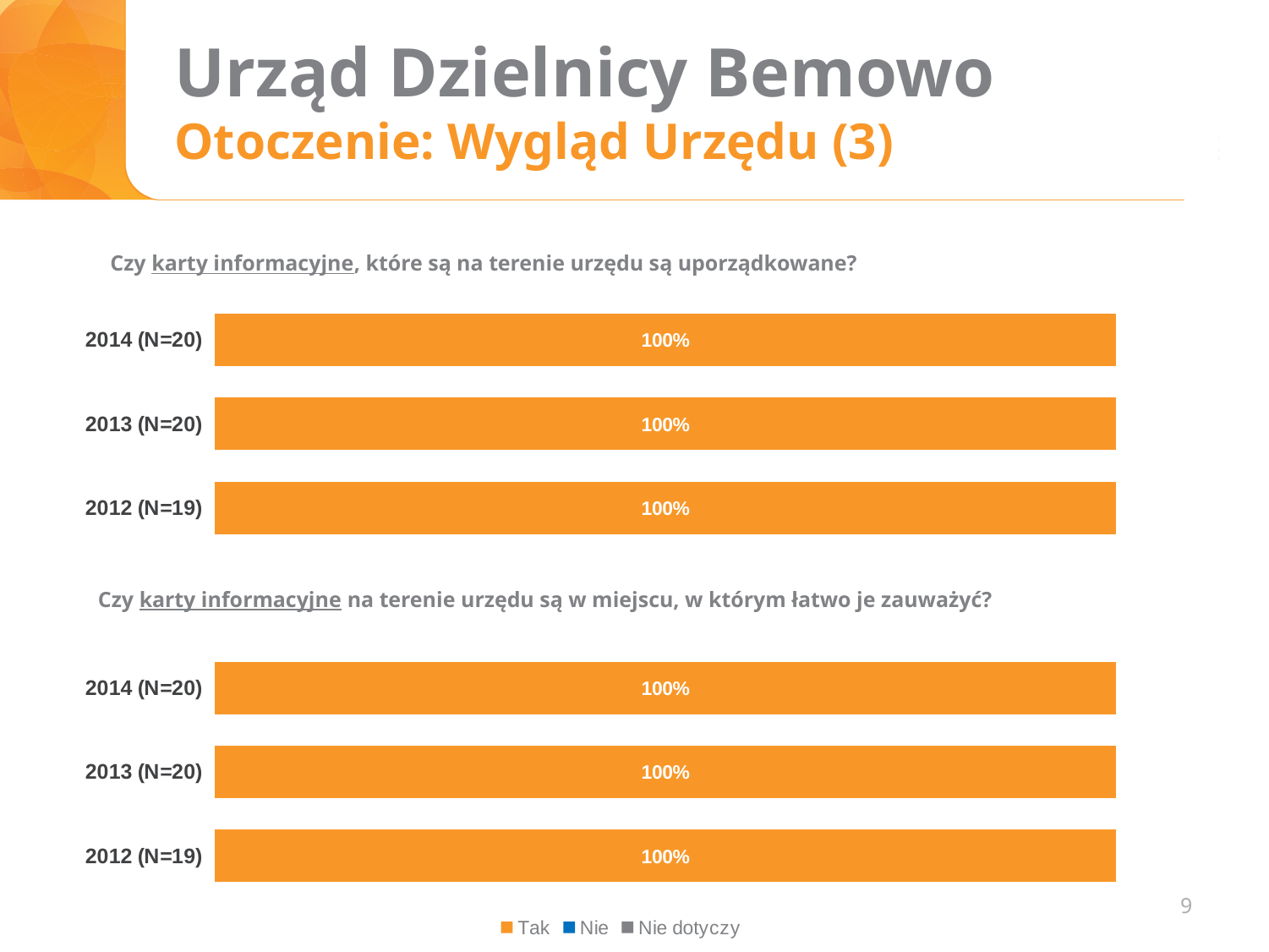
In the bottom chart, do the values change between 2012 (N=19) and 2014 (N=20)? No, they stay at 100% What kind of chart is the top chart? Bar chart Which legend entry is shown in orange? Tak In the top chart, what is the value shown for 2012 (N=19)? 100% How many series does the legend at the bottom of the slide list? 3 In the top chart, what is the difference between the value for 2014 (N=20) and the value for 2012 (N=19)? 0% How many categories (years) are shown in the bottom chart? 3 In the top chart ("Czy karty informacyjne, które są na terenie urzędu są uporządkowane?"), what is the value for 2014 (N=20)? 100% How many categories (years) are shown in the top chart? 3 In the bottom chart, what is the value shown for 2014 (N=20)? 100% In the bottom chart ("Czy karty informacyjne na terenie urzędu są w miejscu, w którym łatwo je zauważyć?"), what is the value for 2013 (N=20)? 100% What are the three entries listed in the legend? Tak, Nie, Nie dotyczy